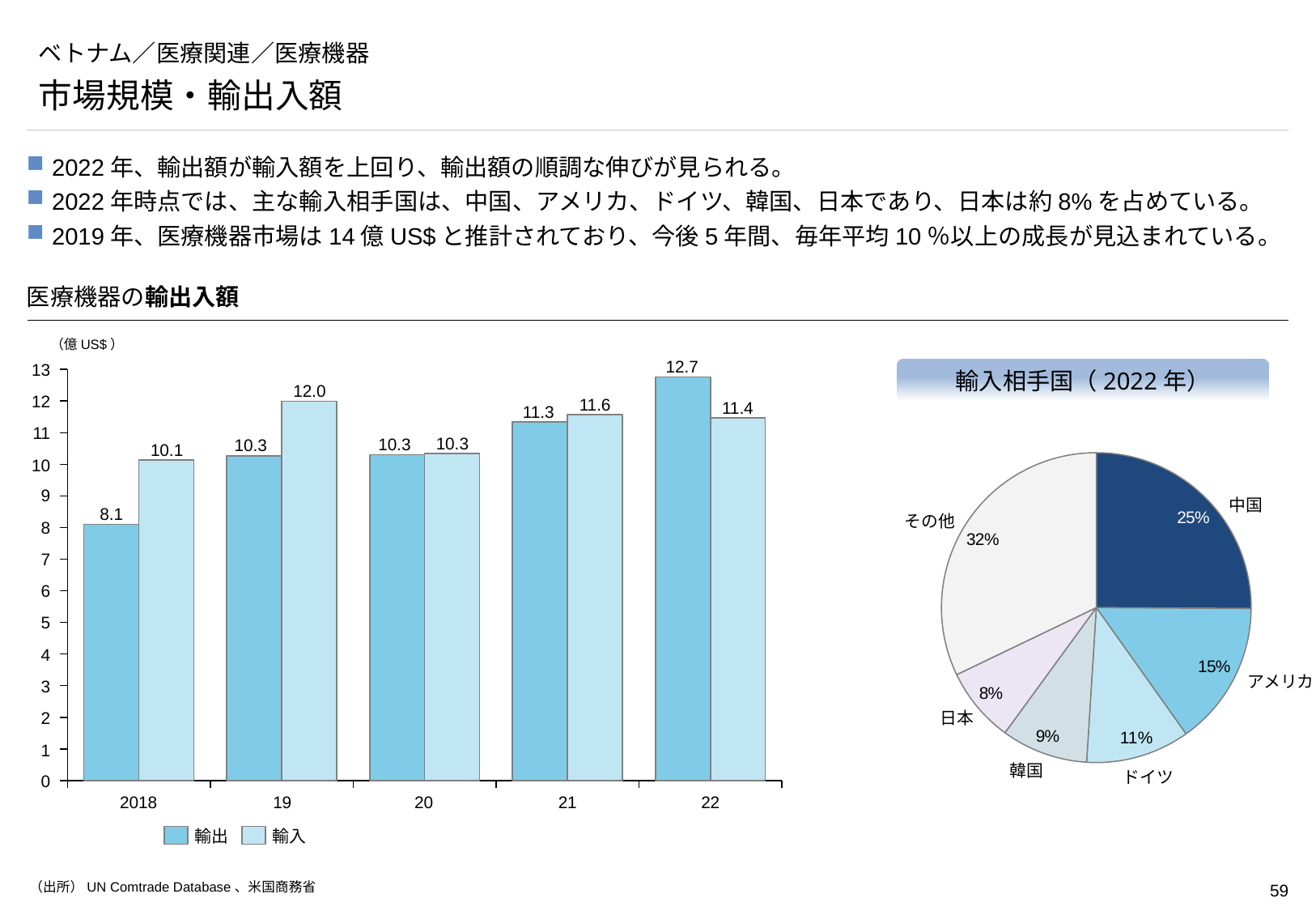
In the bar chart 医療機器の輸出入額, how many series does the legend list? 2 In the bar chart 医療機器の輸出入額, which year has the highest 輸出 value? 22 In the bar chart 医療機器の輸出入額, which year has the lowest 輸出 value? 2018 What kind of chart is the chart on the right, 輸入相手国（2022年）? pie chart In the bar chart 医療機器の輸出入額, does the 輸出 value rise or fall from 2018 to 22? rise In the bar chart 医療機器の輸出入額, what is the difference between 輸出 and 輸入 in 22? 1.3 In the bar chart 医療機器の輸出入額, how many years are shown on the x axis? 5 In the pie chart 輸入相手国（2022年）, which named country has the smallest share? 日本 In the pie chart 輸入相手国（2022年）, what share does 中国 have? 25% In the bar chart 医療機器の輸出入額, which is larger in 2018, 輸出 or 輸入? 輸入 In the bar chart 医療機器の輸出入額, what is the 輸出 value for 2018? 8.1 In the bar chart 医療機器の輸出入額, what is the 輸入 value for 19? 12.0